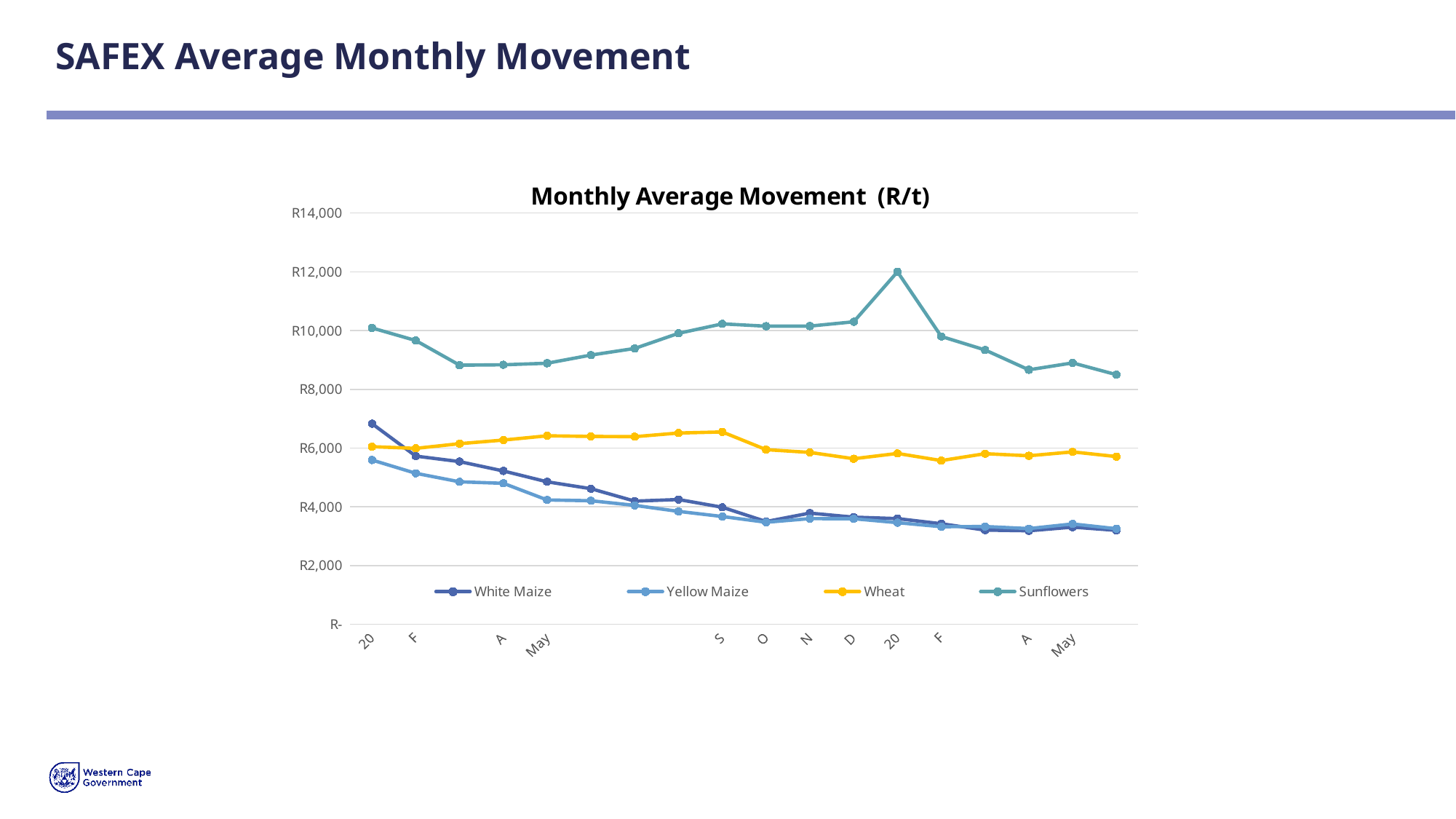
How many data points does each series have? 18 Is the value for White Maize at the first point on the x axis greater or less than R6,000? greater Which series is plotted in yellow? Wheat Which series has the lowest value at the first point on the x axis? Yellow Maize Is the value for Yellow Maize at the last point on the x axis greater or less than R4,000? less Is the value for Wheat at the last point on the x axis greater or less than R8,000? less What kind of chart is shown on the slide? Line chart What is the title of the chart? Monthly Average Movement (R/t) Do the White Maize values generally rise or fall along the x axis? Fall How many series does the legend list? 4 At the last point on the x axis, which is larger: Wheat or White Maize? Wheat Which series has the highest values across the whole chart? Sunflowers